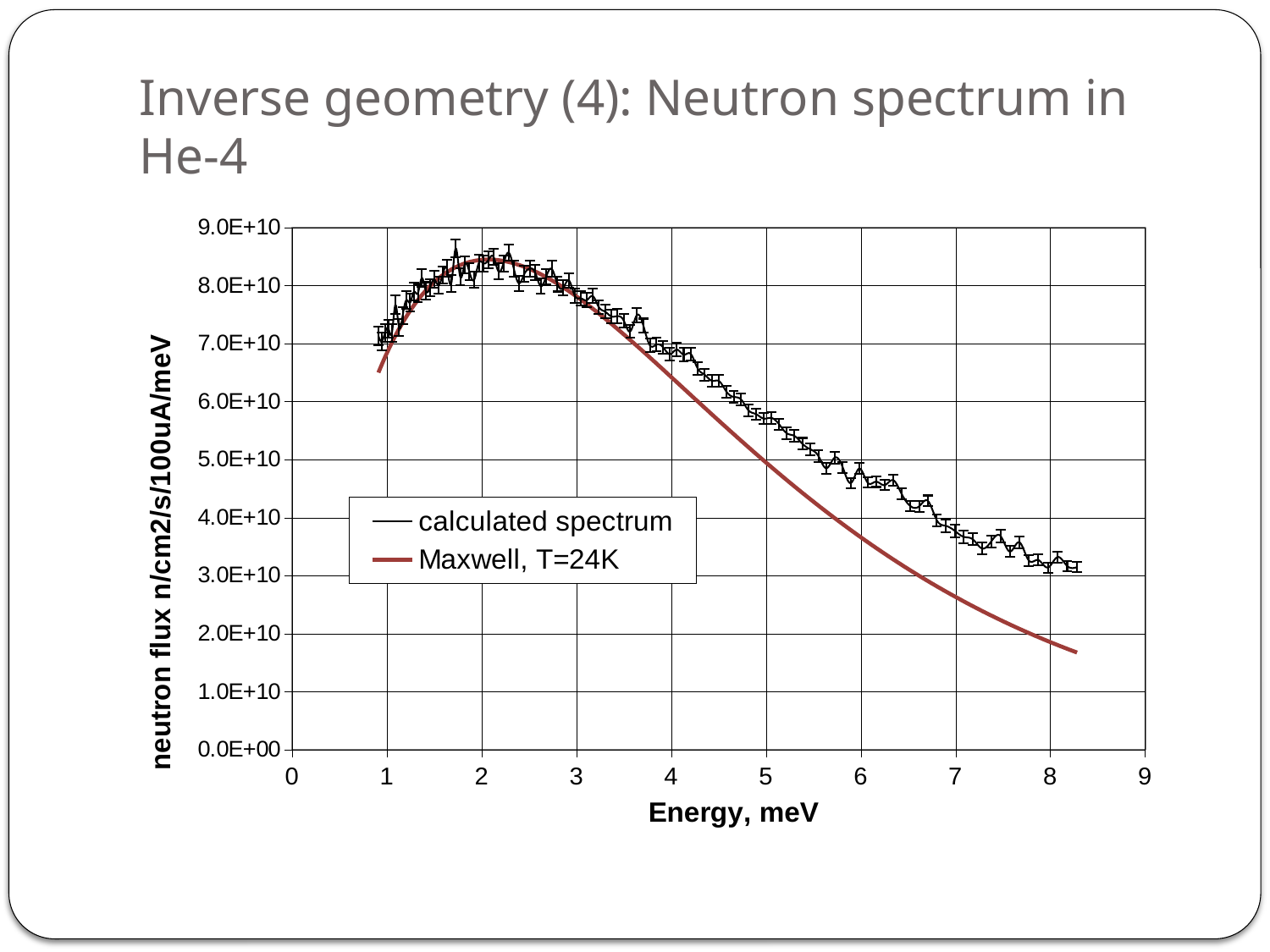
What are the two series named in the legend? calculated spectrum; Maxwell, T=24K Is the peak value of the calculated spectrum greater or less than 9.0E+10? less Between 3 meV and 8 meV, does the calculated spectrum rise or fall as energy increases? fall What kind of chart is shown on the slide? line chart Is the value of the calculated spectrum at 5 meV greater or less than 5.0E+10? greater What is the x-axis title of the chart? Energy, meV Is the value of the Maxwell, T=24K curve at 6 meV greater or less than 4.0E+10? less At 7 meV, which series has the larger value, the calculated spectrum or the Maxwell, T=24K curve? calculated spectrum How many series does the legend list? 2 Between 1 meV and 2 meV, does the Maxwell, T=24K curve rise or fall as energy increases? rise